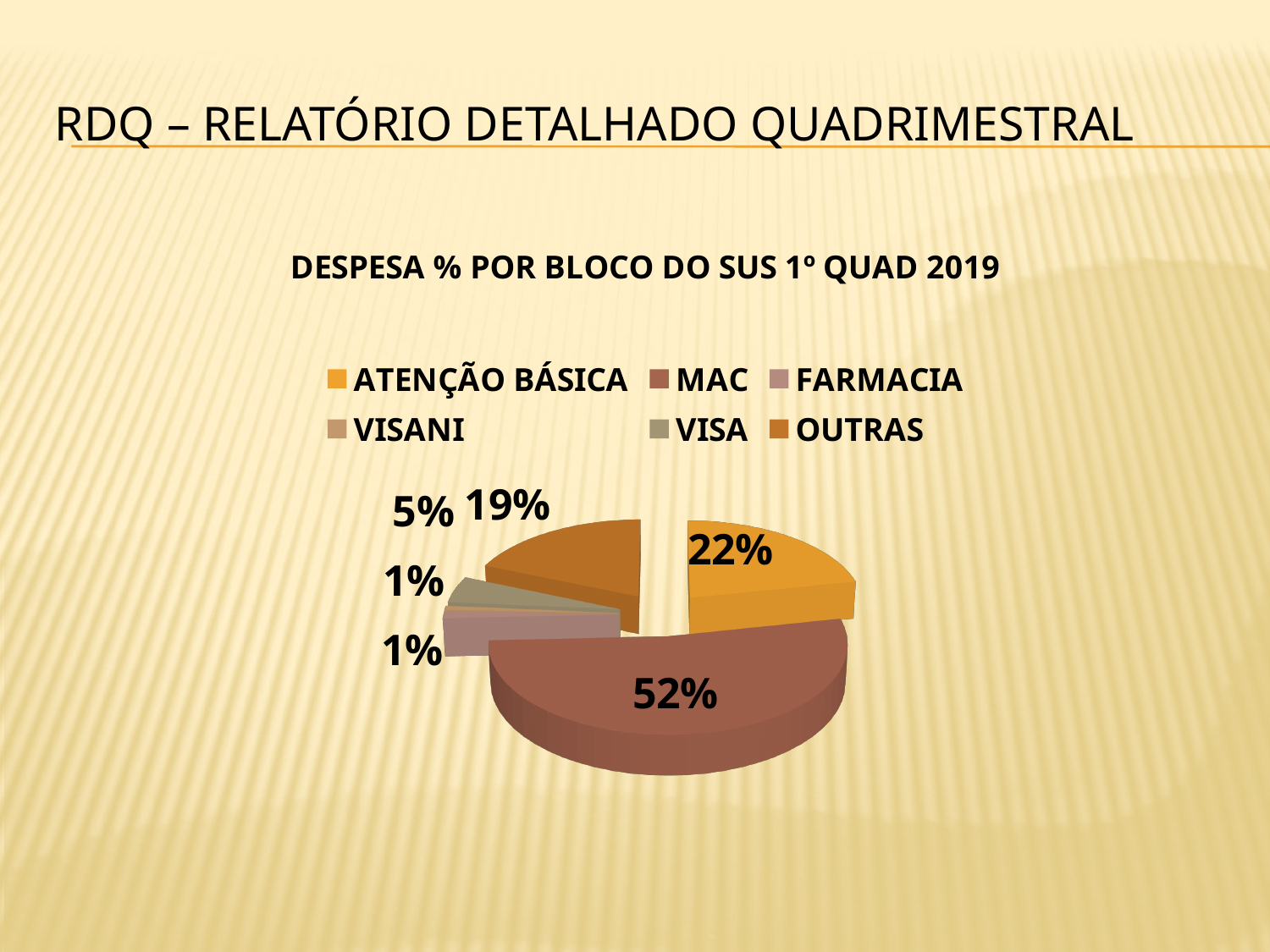
How many slices does the pie chart have? 6 What is the value shown for ATENÇÃO BÁSICA? 22% By how many percentage points does MAC exceed ATENÇÃO BÁSICA? 30 percentage points What is the difference between the ATENÇÃO BÁSICA share and the OUTRAS share? 3 percentage points What is the title of the chart? DESPESA % POR BLOCO DO SUS 1º QUAD 2019 Which block has the largest share of the expenses? MAC Which legend entry is shown in the yellow-orange colour? ATENÇÃO BÁSICA What percentage is shown for OUTRAS? 19% What percentage of the pie does MAC account for? 52% How many categories does the legend list? 6 What type of chart is shown on the slide? Pie chart Which is larger, the share for ATENÇÃO BÁSICA or the share for OUTRAS? ATENÇÃO BÁSICA